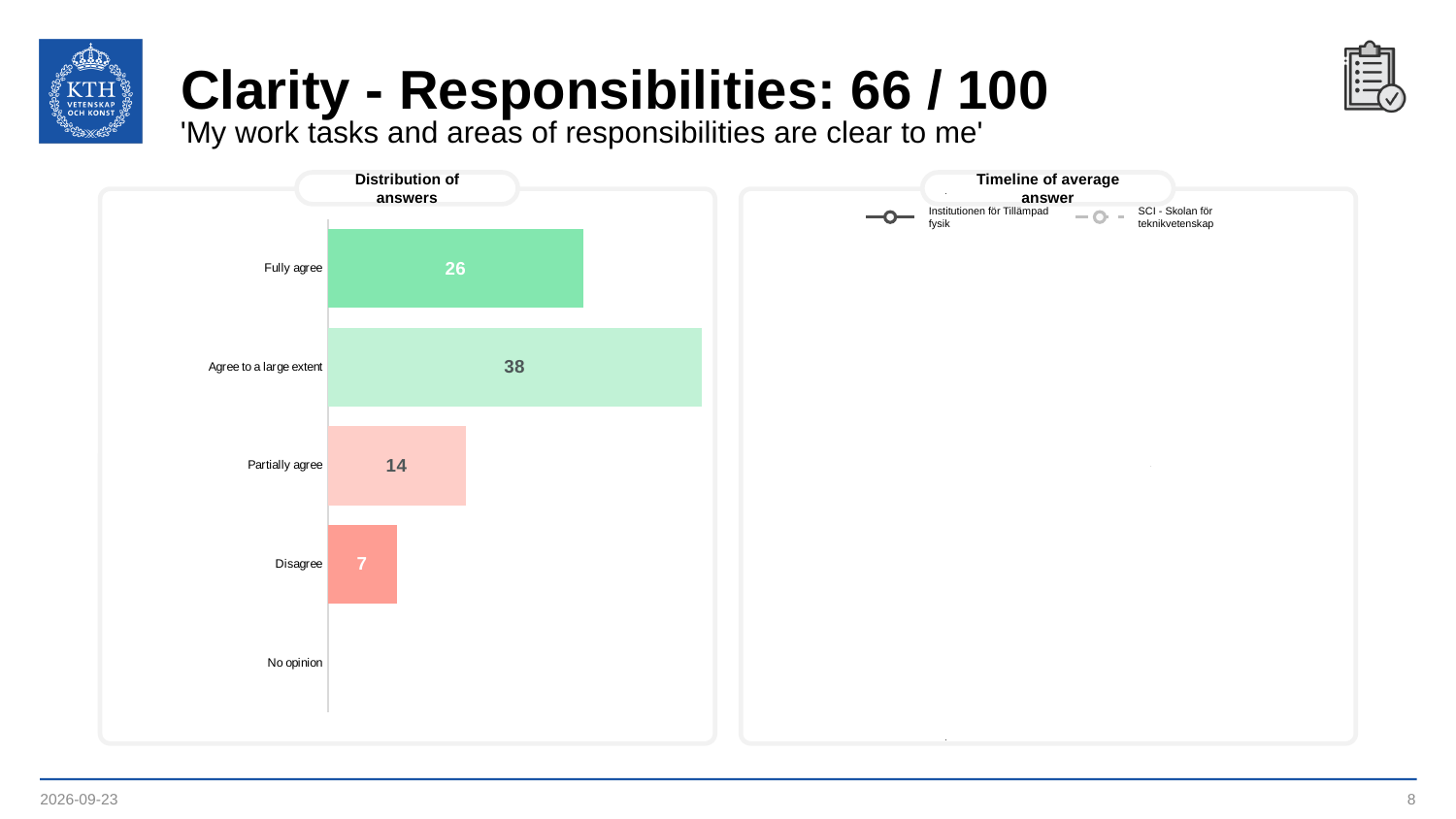
In the 'Distribution of answers' chart, which is larger: the value for 'Partially agree' or the value for 'Disagree'? Partially agree How many series does the legend of the 'Timeline of average answer' chart list? 2 In the 'Distribution of answers' chart, what is the difference between the values for 'Agree to a large extent' and 'Fully agree'? 12 In the 'Distribution of answers' chart, which category has the highest value? Agree to a large extent How many categories are listed on the axis of the 'Distribution of answers' chart? 5 In the 'Distribution of answers' chart, what is the value for 'Agree to a large extent'? 38 In the 'Distribution of answers' chart, what is the value for 'Disagree'? 7 In the 'Distribution of answers' chart, what is the value for 'Partially agree'? 14 What kind of chart is the 'Distribution of answers' chart? Bar chart In the 'Distribution of answers' chart, what is the value for 'Fully agree'? 26 In the 'Distribution of answers' chart, which of the labelled bars has the lowest value? Disagree What are the two legend entries in the 'Timeline of average answer' chart? Institutionen för Tillämpad fysik; SCI - Skolan för teknikvetenskap